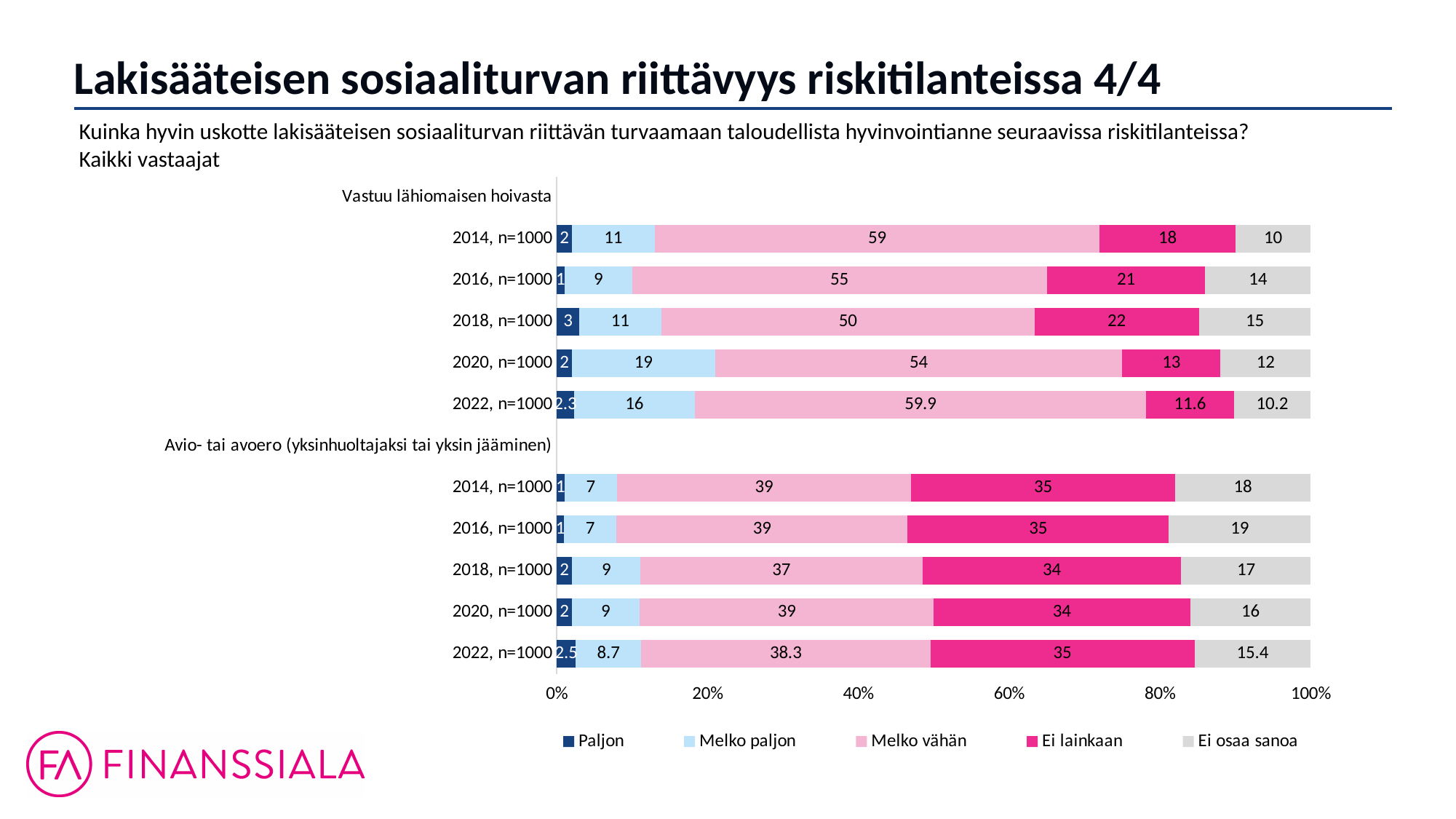
Among the 'Vastuu lähiomaisen hoivasta' bars, which year has the lowest 'Ei lainkaan' value? 2022, n=1000 Among the 'Vastuu lähiomaisen hoivasta' bars, which year has the highest 'Ei lainkaan' value? 2018, n=1000 What is the 'Ei lainkaan' value for 'Avio- tai avoero (yksinhuoltajaksi tai yksin jääminen)' in 2022, n=1000? 35 How many series does the legend list? 5 What is the 'Melko vähän' value for 'Vastuu lähiomaisen hoivasta' in 2014, n=1000? 59 Which legend entry is shown in dark blue? Paljon What is the difference between the 'Ei lainkaan' values for 'Vastuu lähiomaisen hoivasta' in 2018, n=1000 and 2020, n=1000? 9 What is the 'Melko paljon' value for 'Vastuu lähiomaisen hoivasta' in 2020, n=1000? 19 Which is larger: the 'Melko vähän' value for 'Vastuu lähiomaisen hoivasta' in 2016, n=1000 or for 'Avio- tai avoero (yksinhuoltajaksi tai yksin jääminen)' in 2016, n=1000? Vastuu lähiomaisen hoivasta, 2016, n=1000 What type of chart is shown on the slide? Stacked bar chart How many bars are plotted in the chart in total? 10 What is the 'Ei osaa sanoa' value for 'Vastuu lähiomaisen hoivasta' in 2022, n=1000? 10.2